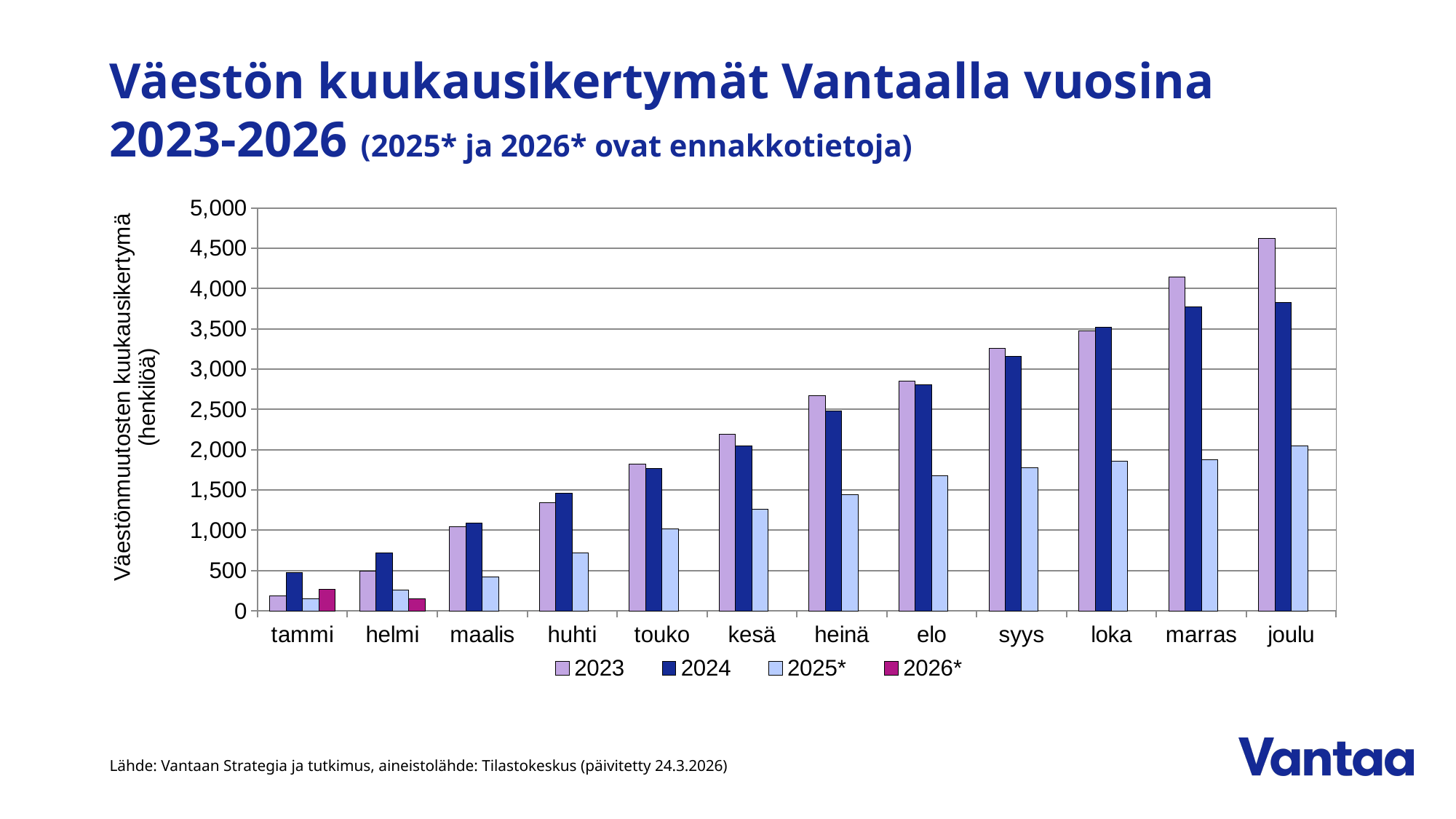
For tammi, which series has the larger value, 2023 or 2024? 2024 Which month has the highest value for the 2023 series? joulu Is the 2023 value for joulu greater or less than 4,500? greater Is the 2024 value for joulu greater or less than 4,000? less How many series does the legend list? 4 What kind of chart is shown on the slide? bar chart For marras, which series has the larger value, 2023 or 2024? 2023 How many months are shown on the x axis? 12 Which month has the lowest value for the 2025* series? tammi Is the 2024 value for marras greater or less than 3,500? greater Do the 2025* values rise or fall from tammi to joulu? rise